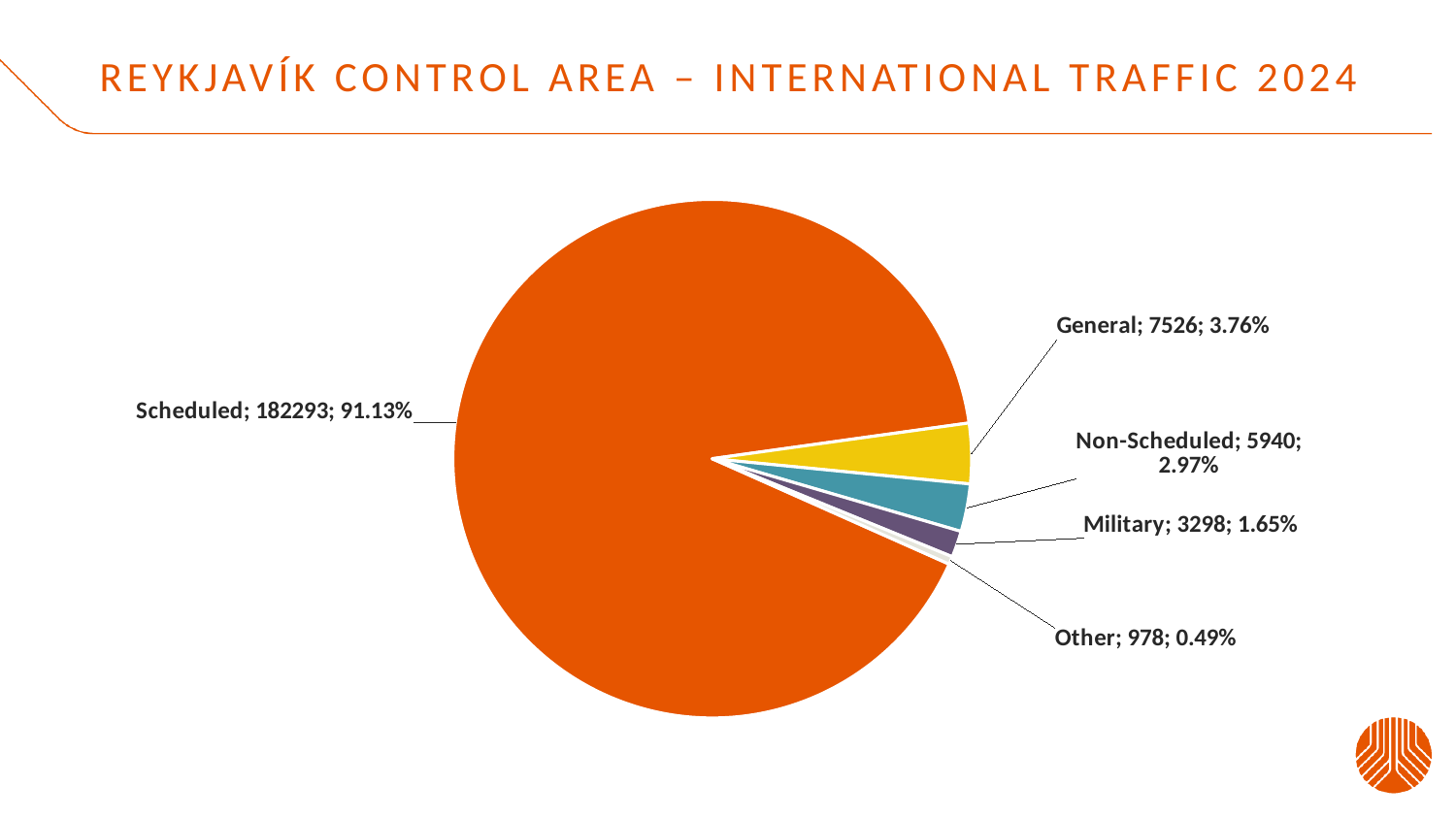
Which category has the largest slice? Scheduled What share of the pie does the Scheduled slice represent? 91.13% What kind of chart is shown on the slide? Pie chart What is the value for Scheduled traffic? 182293 Which category has the smallest slice? Other What is the value for Military traffic? 3298 Which is larger, the Military value or the Other value? Military What is the value for General traffic? 7526 How many categories are shown in the pie chart? 5 What is the value for Non-Scheduled traffic? 5940 What share of the pie does the Other slice represent? 0.49% What is the difference between the General and Non-Scheduled values? 1586